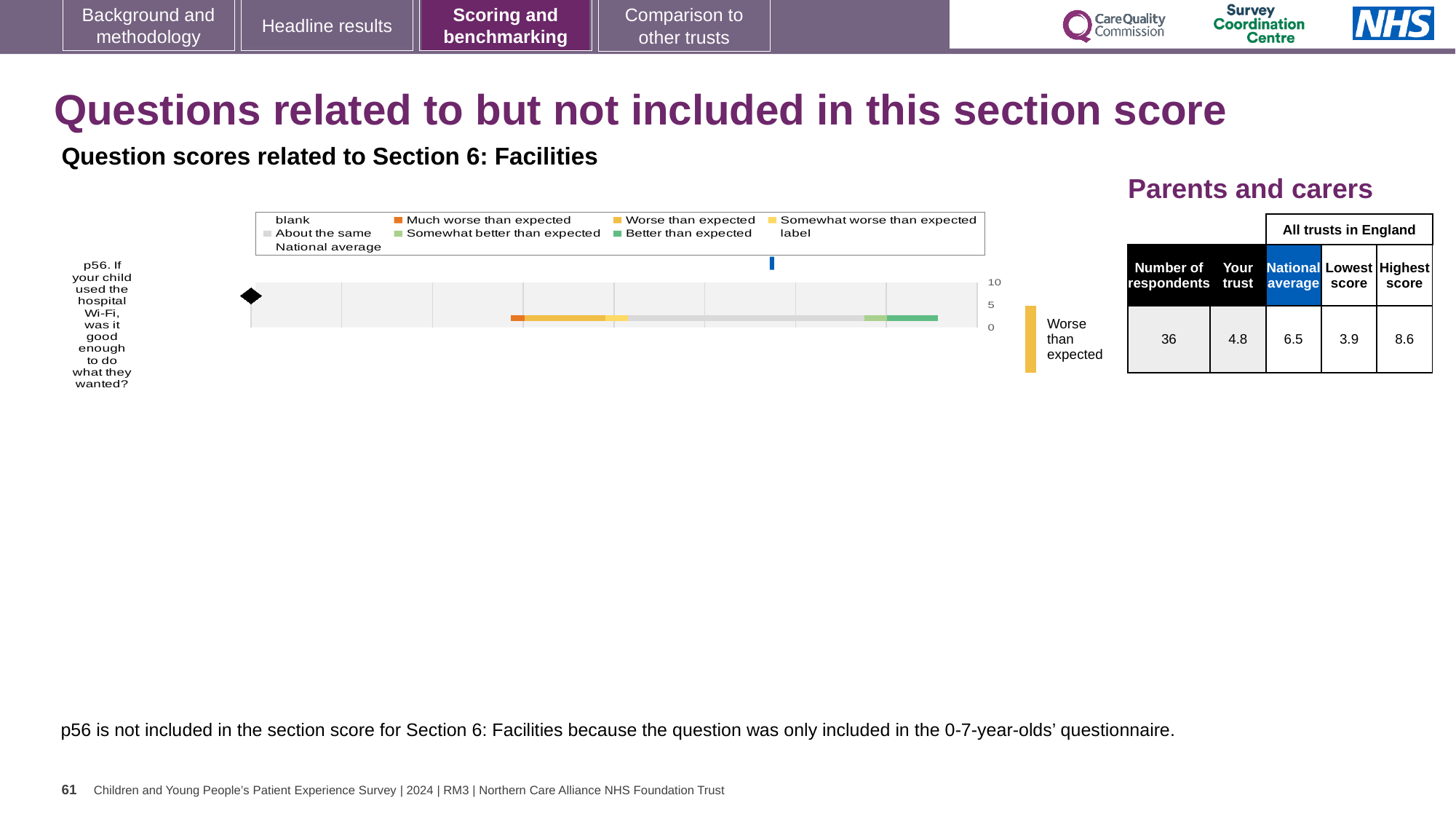
What is the lowest score among all trusts in England for p56? 3.9 How many questions (categories) are plotted in the chart? 1 Which question is plotted in the chart? p56. If your child used the hospital Wi-Fi, was it good enough to do what they wanted? What is the trust's score for p56? 4.8 Which colour in the legend represents 'Much worse than expected'? orange What kind of chart is shown on the slide? bar chart How many respondents answered p56? 36 What is the national average score for p56? 6.5 What benchmark category is the trust's score for p56 given as? Worse than expected What is the difference between the national average and the trust's score for p56? 1.7 What is the highest score among all trusts in England for p56? 8.6 Which is larger for p56, the trust's score or the national average? national average